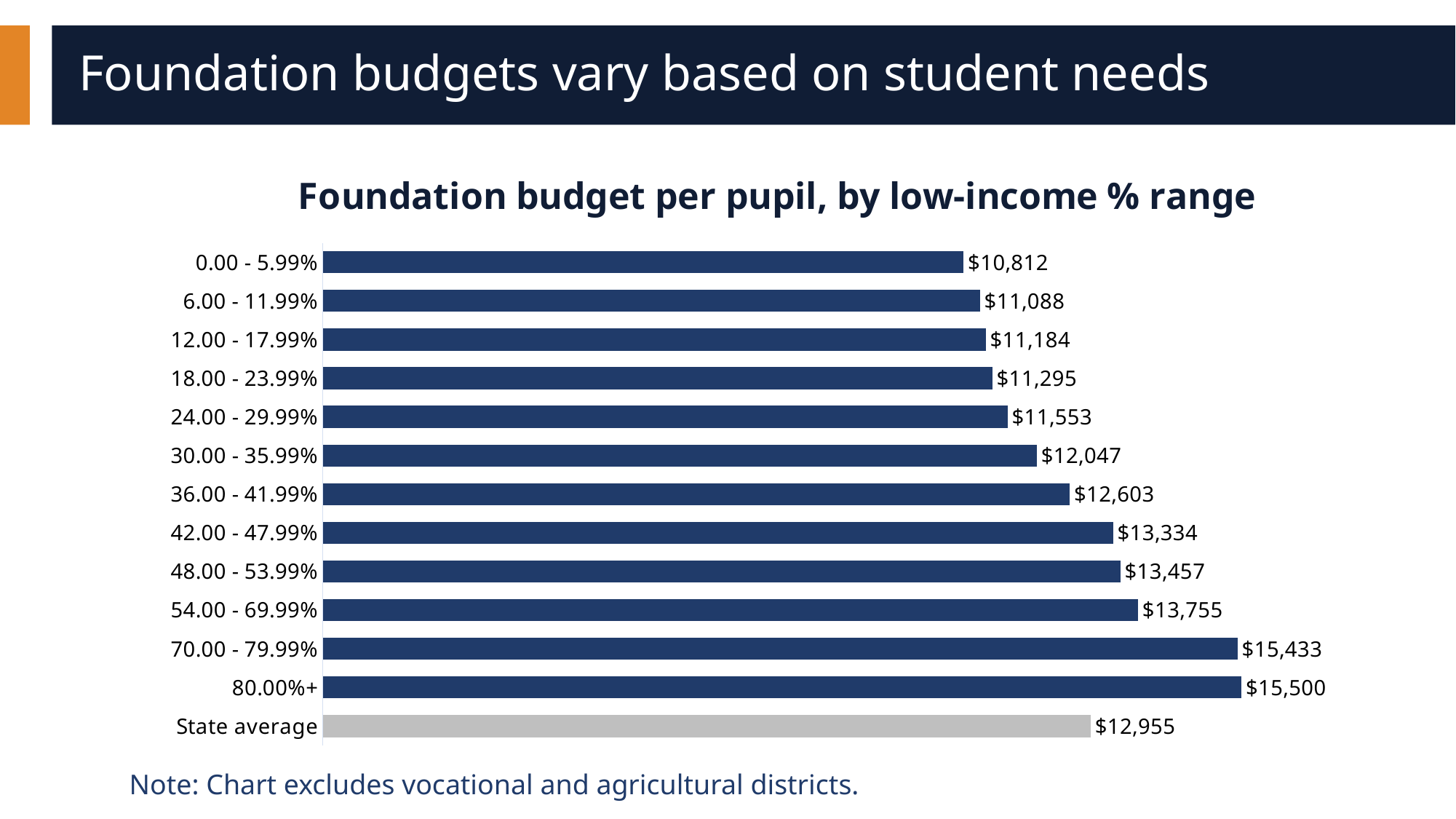
Which has a higher foundation budget per pupil: the 54.00 - 69.99% range or the State average? 54.00 - 69.99% Do foundation budgets per pupil rise or fall as the low-income % range increases? Rise How much higher is the State average than the foundation budget per pupil for the 36.00 - 41.99% range? $352 What is the State average foundation budget per pupil shown on the chart? $12,955 What is the difference in foundation budget per pupil between the 80.00%+ range and the 0.00 - 5.99% range? $4,688 Which bar on the chart is coloured grey rather than dark blue? State average What is the foundation budget per pupil for the 0.00 - 5.99% low-income range? $10,812 How many bars are shown on the chart, including the State average? 13 Which low-income % range has the highest foundation budget per pupil? 80.00%+ What is the foundation budget per pupil for the 42.00 - 47.99% low-income range? $13,334 What type of chart is shown on the slide? Bar chart Which low-income % range has the lowest foundation budget per pupil? 0.00 - 5.99%